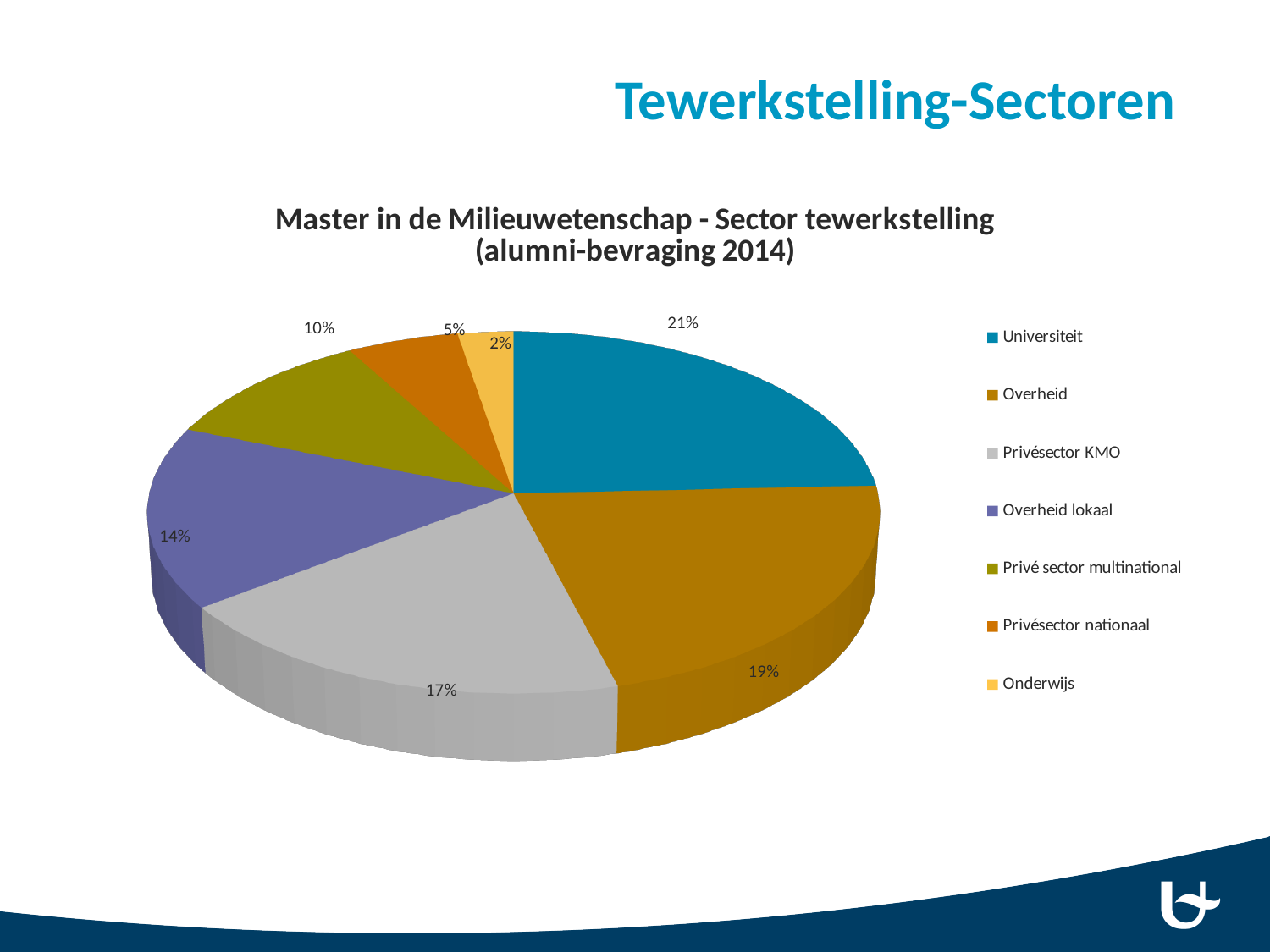
What share of the pie does Onderwijs have? 2% What is the difference between the shares of Universiteit and Privésector nationaal? 16% Which sector has the largest share of the pie? Universiteit What kind of chart is shown on the slide? Pie chart Which has a larger share, Overheid lokaal or Privé sector multinational? Overheid lokaal What share of the pie does Universiteit have? 21% How many sectors does the legend list? 7 What share of the pie does Privésector KMO have? 17% What share of the pie does Overheid lokaal have? 14% What is the title of the chart? Master in de Milieuwetenschap - Sector tewerkstelling (alumni-bevraging 2014) Which sector has the smallest share of the pie? Onderwijs What share of the pie does Overheid have? 19%